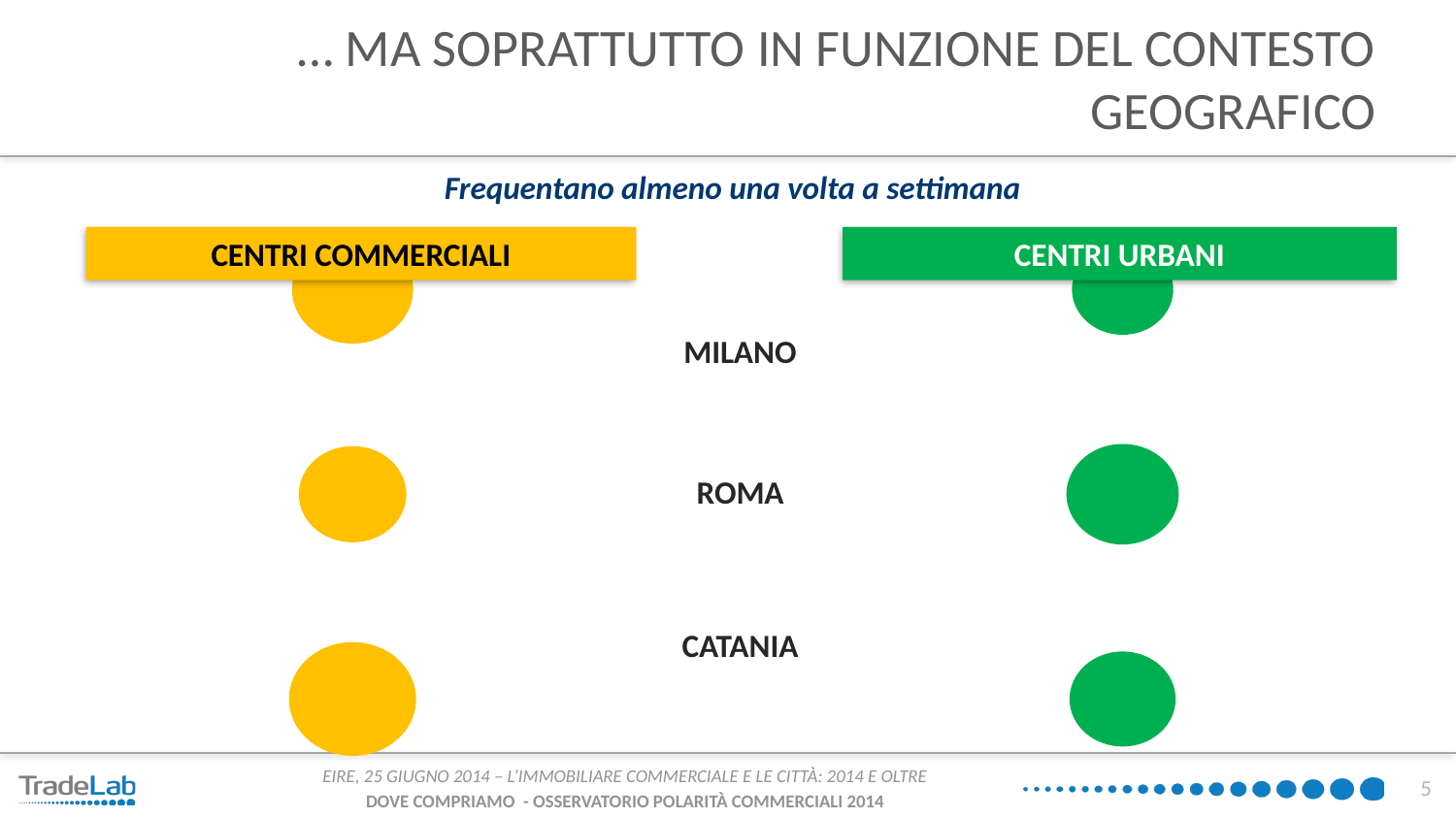
What kind of chart is used on the slide to show the frequency of visits? bubble chart What are the two series compared on the chart? Centri Commerciali and Centri Urbani How many series (contexts) does the chart compare? 2 Which city has the smallest bubble for Centri Urbani? Milano For Catania, which bubble is larger: Centri Commerciali or Centri Urbani? Centri Commerciali How many cities are shown on the chart? 3 What is the subtitle describing what the bubbles represent? Frequentano almeno una volta a settimana Which city has the largest bubble for Centri Commerciali? Catania What colour are the bubbles for Centri Urbani? green For Milano, which bubble is larger: Centri Commerciali or Centri Urbani? Centri Commerciali Which is larger: the Centri Commerciali bubble for Catania or the Centri Urbani bubble for Milano? Centri Commerciali bubble for Catania